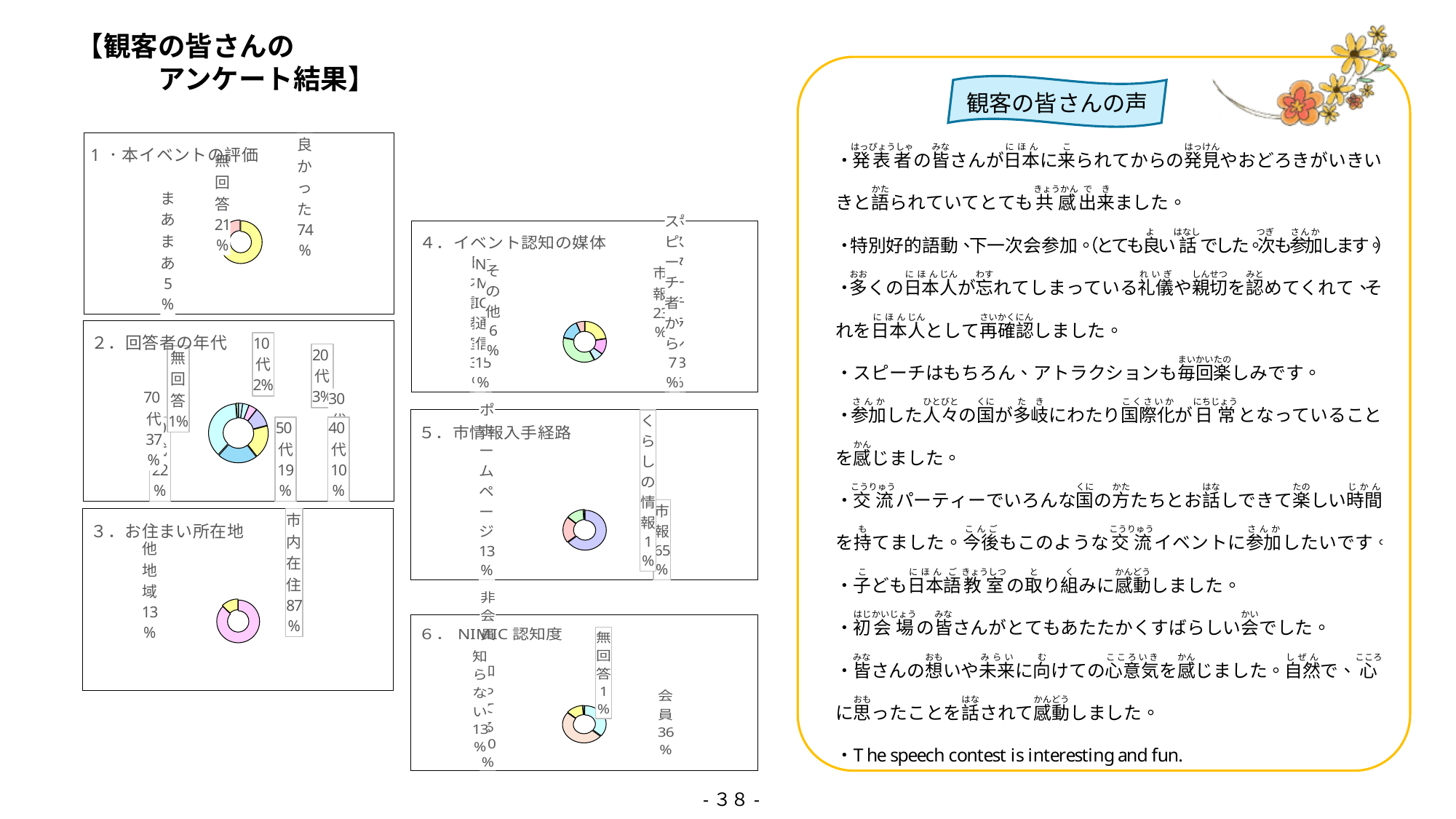
In the chart titled 1・本イベントの評価, what percentage is shown for まあまあ? 5% In the chart titled 2・回答者の年代, which is larger, 70代 or 10代? 70代 In the chart titled 2・回答者の年代, what percentage is shown for 40代? 10% In the chart titled 5・市情報入手経路, what percentage is shown for 市報? 65% In the chart titled 1・本イベントの評価, what percentage is shown for 無回答? 21% In the chart titled 3・お住まい所在地, what percentage is shown for 市内在住? 87% In the chart titled 3・お住まい所在地, what is the difference in percentage points between 市内在住 and 他地域? 74 In the chart titled 3・お住まい所在地, what percentage is shown for 他地域? 13% What type of chart is used for 6・NIMIC認知度? Donut (pie) chart In the chart titled 1・本イベントの評価, what percentage is shown for 良かった? 74% In the chart titled 1・本イベントの評価, which category has the largest share? 良かった In the chart titled 2・回答者の年代, what percentage is shown for 50代? 19%